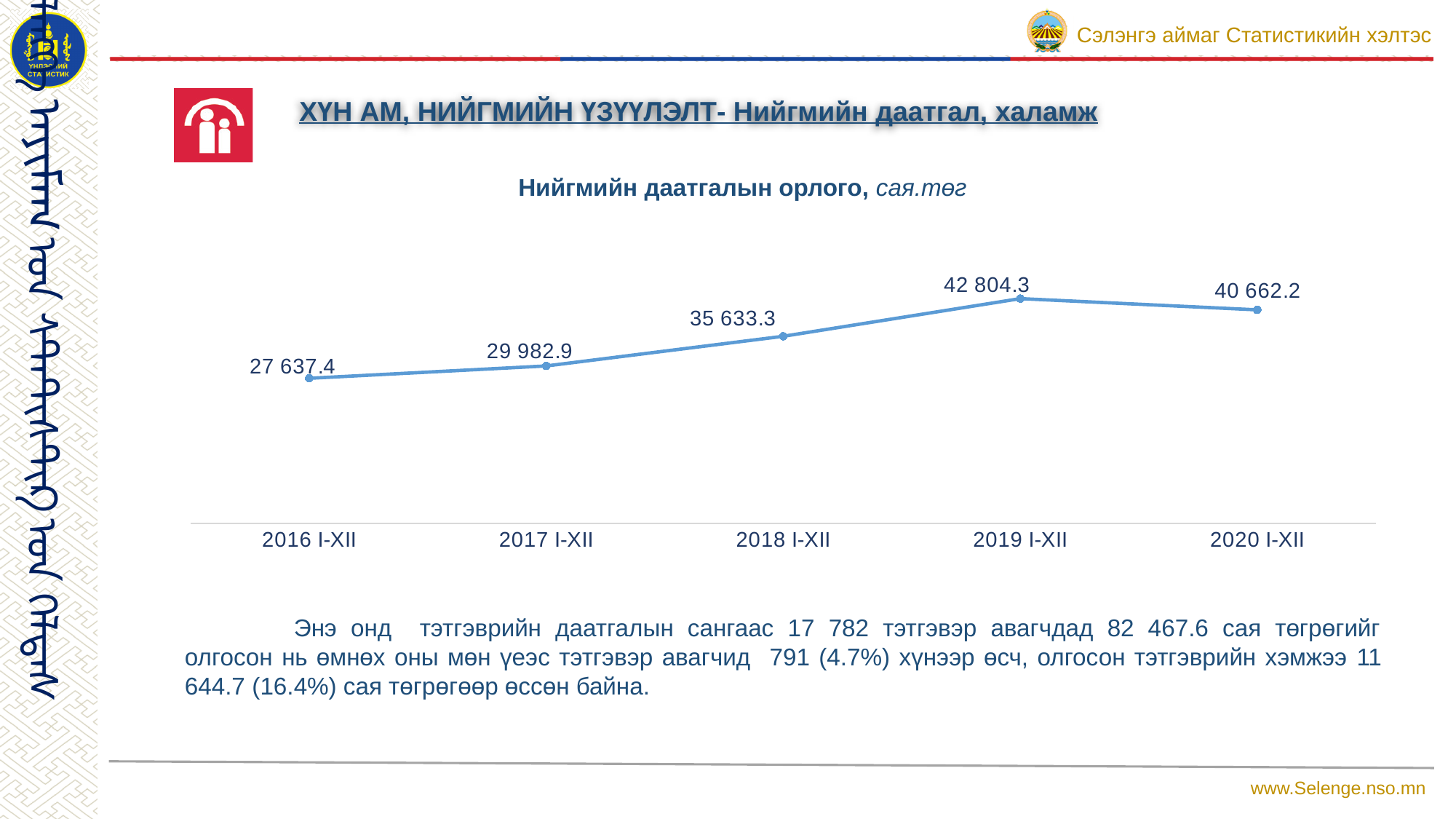
Which period has the lowest value? 2016 I-XII What is the value for 2017 I-XII? 29 982.9 What kind of chart is shown? Line chart What is the value for 2020 I-XII? 40 662.2 What is the title of the chart? Нийгмийн даатгалын орлого, сая.төг How many data points are plotted on the chart? 5 Which period has the highest value? 2019 I-XII Which is larger, the value for 2020 I-XII or the value for 2018 I-XII? 2020 I-XII What is the value for 2018 I-XII? 35 633.3 What is the difference between the values for 2019 I-XII and 2018 I-XII? 7 171.0 By how much did the value fall from 2019 I-XII to 2020 I-XII? 2 142.1 What is the value for 2016 I-XII? 27 637.4